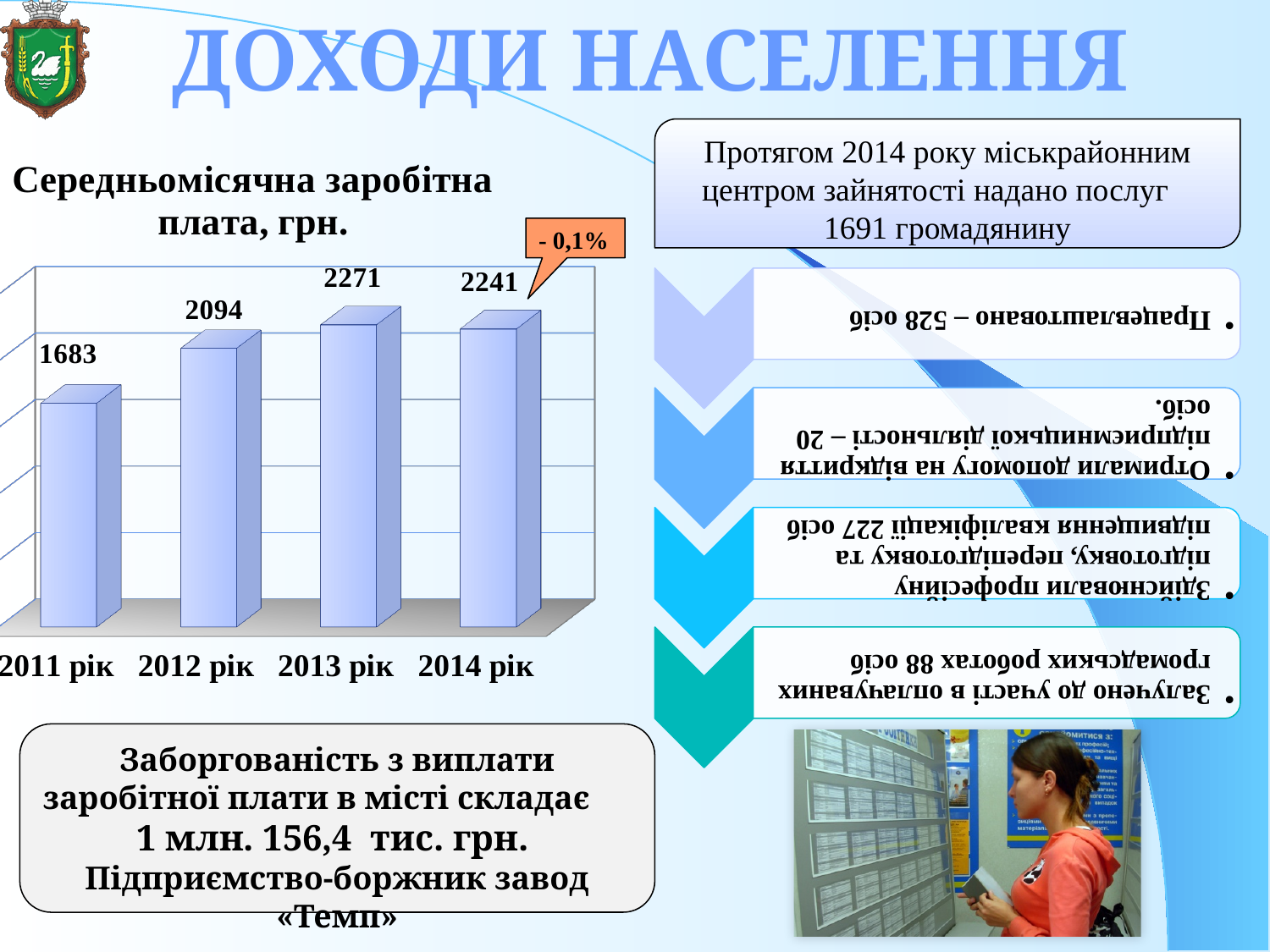
Which is larger, the value for 2012 рік or the value for 2014 рік? 2014 рік By how much did the value change from 2013 рік to 2014 рік? 30 What is the average monthly salary shown for 2013 рік? 2271 What is the value for 2014 рік in the chart? 2241 How many years are shown on the x axis of the chart? 4 What is the title of the chart? Середньомісячна заробітна плата, грн. What value does the chart show for 2011 рік? 1683 What kind of chart is used to show the average monthly salary? bar chart What is the difference between the values for 2012 рік and 2011 рік? 411 What percentage change is shown in the callout next to the 2014 рік bar? - 0,1% Which year has the lowest value in the chart? 2011 рік Which year has the highest average monthly salary in the chart? 2013 рік